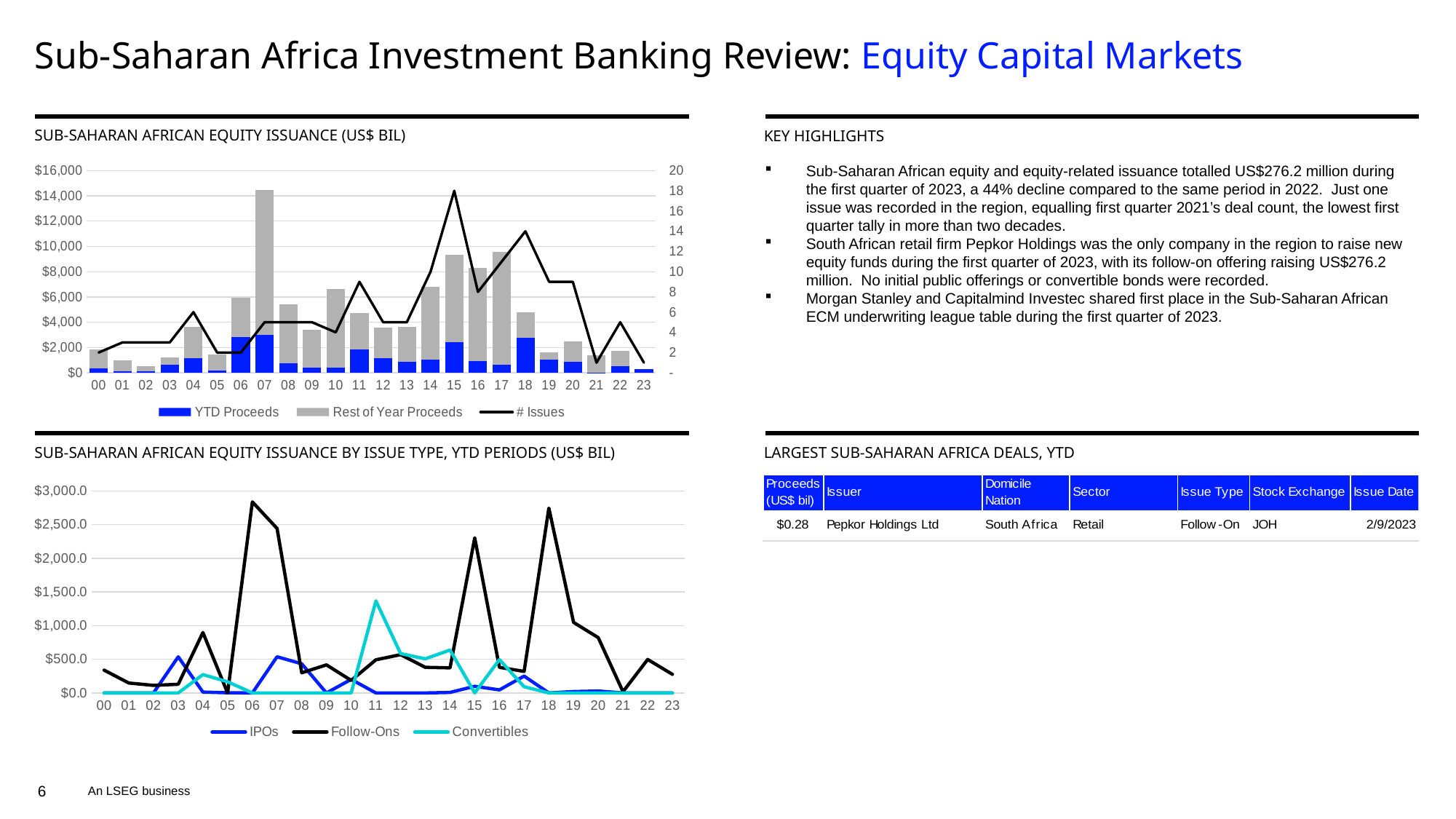
In the chart titled 'SUB-SAHARAN AFRICAN EQUITY ISSUANCE (US$ BIL)', in which year does the # Issues line reach its highest point? 15 In the chart titled 'SUB-SAHARAN AFRICAN EQUITY ISSUANCE BY ISSUE TYPE, YTD PERIODS (US$ BIL)', in which year does the Convertibles line reach its highest point? 11 In the chart titled 'SUB-SAHARAN AFRICAN EQUITY ISSUANCE (US$ BIL)', is the total bar for 18 greater or less than $6,000? less In the chart titled 'SUB-SAHARAN AFRICAN EQUITY ISSUANCE (US$ BIL)', is the # Issues value for 15 greater or less than 16? greater In the chart titled 'SUB-SAHARAN AFRICAN EQUITY ISSUANCE (US$ BIL)', which year has the tallest stacked bar? 07 How many years are shown on the x axis of the chart titled 'SUB-SAHARAN AFRICAN EQUITY ISSUANCE BY ISSUE TYPE, YTD PERIODS (US$ BIL)'? 24 In the chart titled 'SUB-SAHARAN AFRICAN EQUITY ISSUANCE BY ISSUE TYPE, YTD PERIODS (US$ BIL)', is the Follow-Ons value for 06 greater or less than $2,500.0? greater How many series does the legend list in the chart titled 'SUB-SAHARAN AFRICAN EQUITY ISSUANCE (US$ BIL)'? 3 What kind of chart is the one titled 'SUB-SAHARAN AFRICAN EQUITY ISSUANCE BY ISSUE TYPE, YTD PERIODS (US$ BIL)'? Line chart In the chart titled 'SUB-SAHARAN AFRICAN EQUITY ISSUANCE BY ISSUE TYPE, YTD PERIODS (US$ BIL)', which is larger in 11: the Follow-Ons value or the Convertibles value? Convertibles In the chart titled 'SUB-SAHARAN AFRICAN EQUITY ISSUANCE BY ISSUE TYPE, YTD PERIODS (US$ BIL)', which series is drawn in black? Follow-Ons